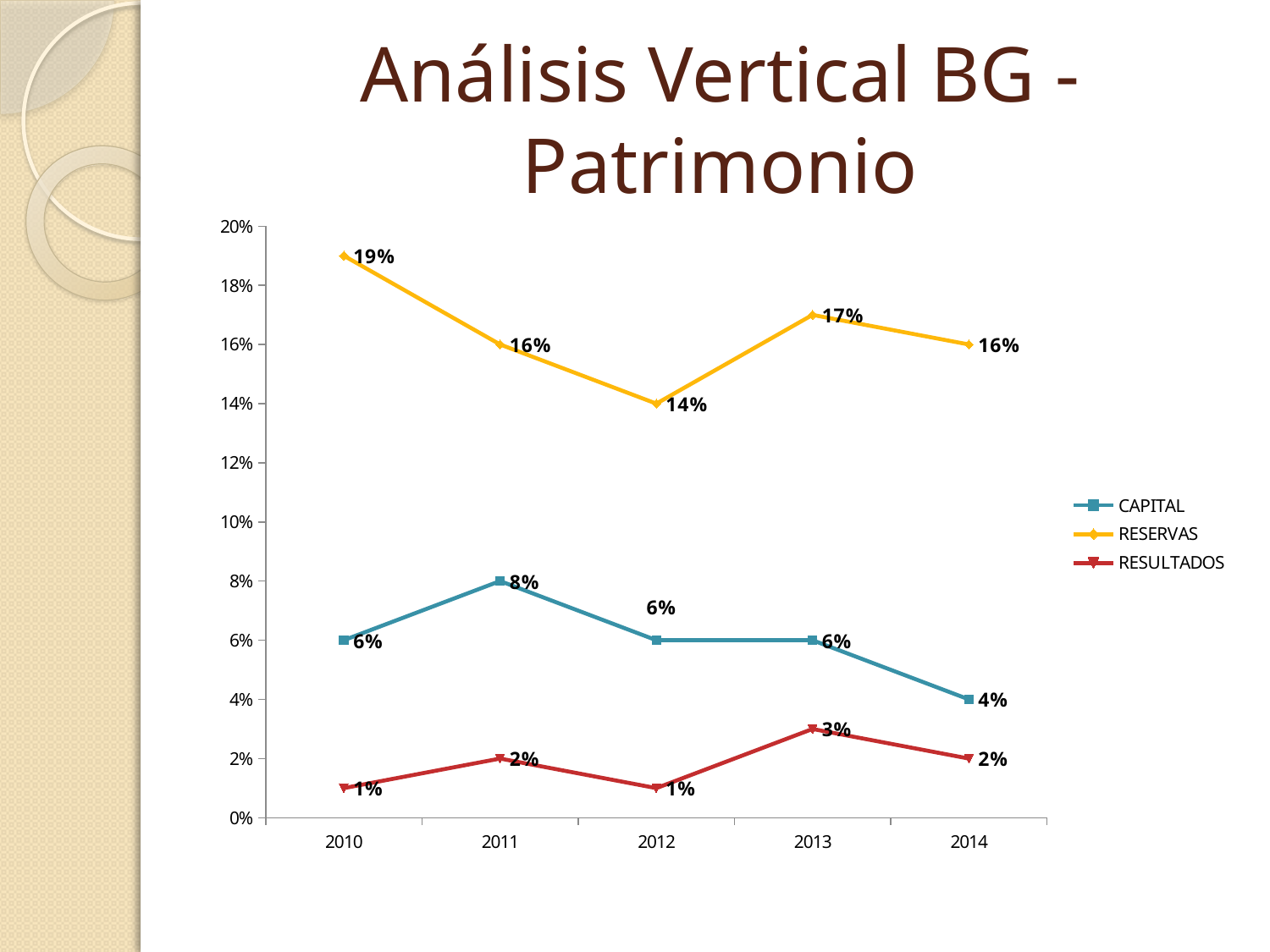
What is the difference between RESERVAS in 2010 and RESERVAS in 2012? 5% Which is larger in 2013: CAPITAL or RESULTADOS? CAPITAL What is the value for CAPITAL in 2011? 8% What is the value for RESERVAS in 2010? 19% In which year is CAPITAL highest? 2011 What is the value for CAPITAL in 2014? 4% What kind of chart is shown on the slide? Line chart What is the value for RESULTADOS in 2013? 3% How many years are shown on the x axis? 5 Does the CAPITAL series rise or fall from 2013 to 2014? Fall In which year is RESERVAS lowest? 2012 How many series does the legend list? 3